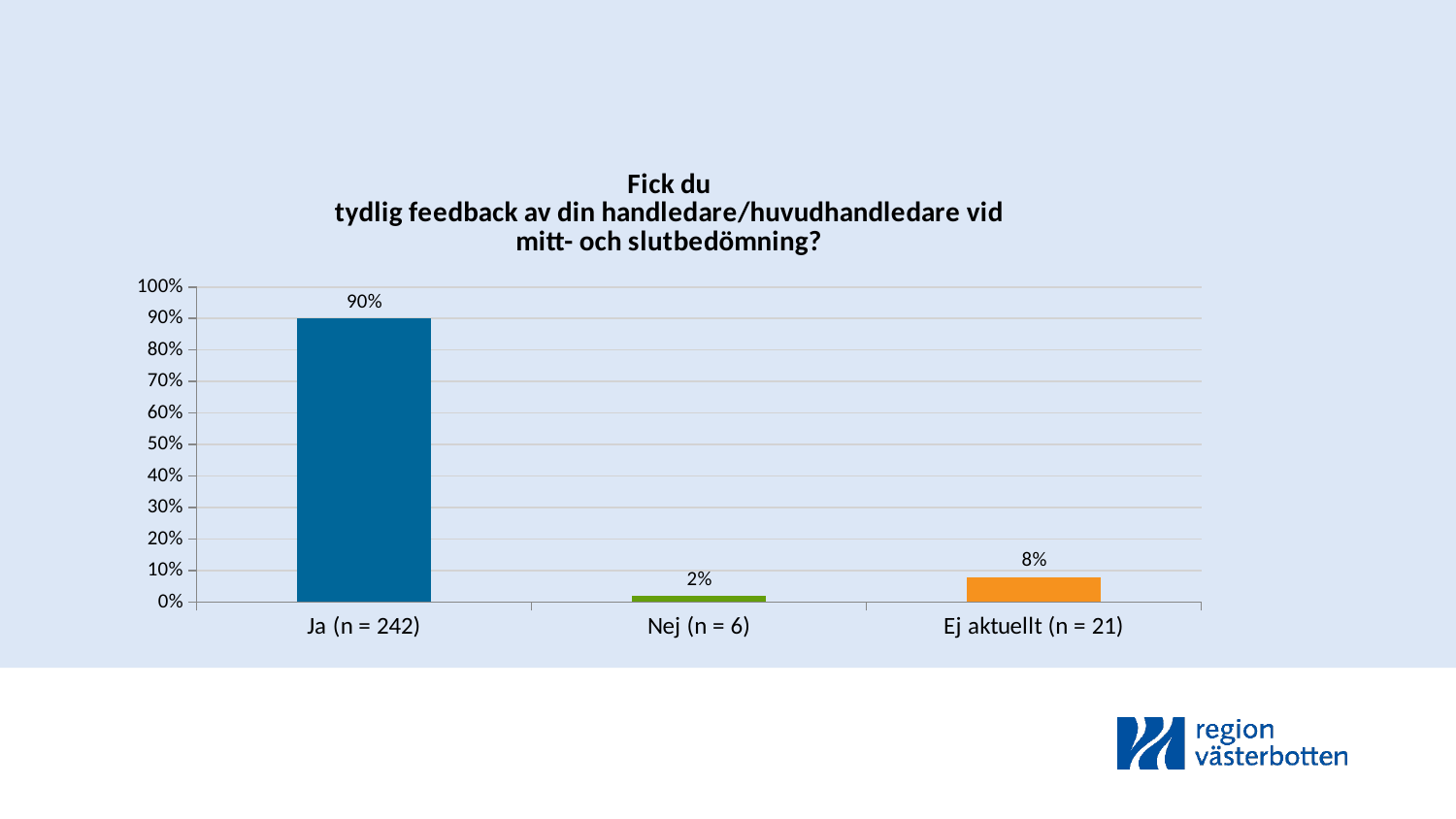
Is the value for "Ja (n = 242)" greater or less than 50%? greater How many categories are shown on the x axis? 3 Which category has the highest percentage? Ja (n = 242) What percentage is shown for "Nej (n = 6)"? 2% What percentage is shown for "Ja (n = 242)"? 90% What percentage is shown for "Ej aktuellt (n = 21)"? 8% What is the highest value shown on the y axis? 100% Which category has the lowest percentage? Nej (n = 6) What kind of chart is shown on the slide? bar chart What is the difference in percentage points between "Ej aktuellt (n = 21)" and "Nej (n = 6)"? 6 Which is larger, the value for "Nej (n = 6)" or the value for "Ej aktuellt (n = 21)"? Ej aktuellt (n = 21) What is the difference in percentage points between "Ja (n = 242)" and "Ej aktuellt (n = 21)"? 82